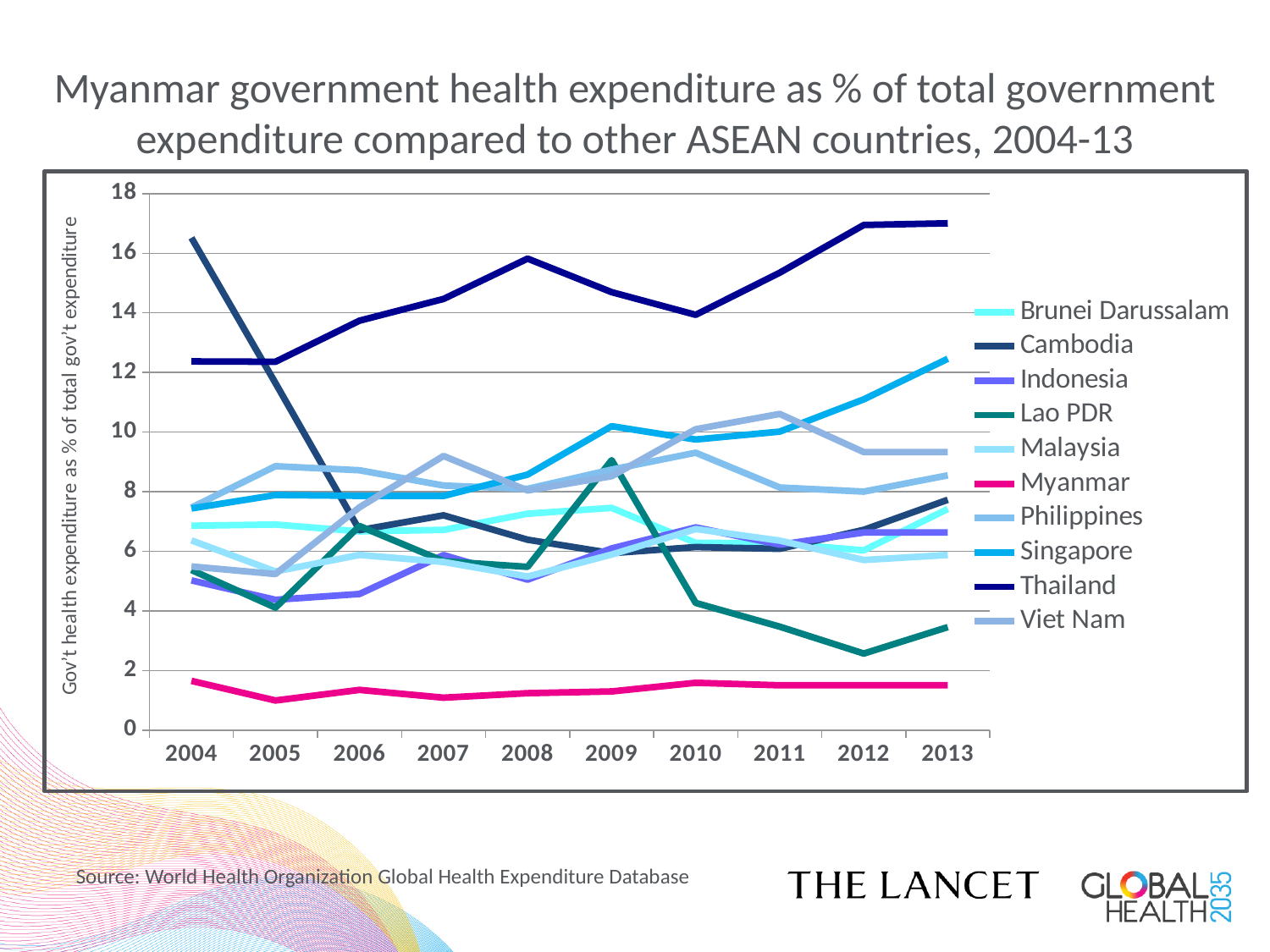
Which country has the highest value in 2004? Cambodia Which country has the lowest value in 2013? Myanmar Which country has the highest value in 2013? Thailand Is the value for Myanmar in 2004 greater or less than 2? less Does the value for Cambodia rise or fall from 2004 to 2006? Fall What kind of chart is shown on the slide? Line chart Is the value for Thailand in 2013 greater or less than 16? greater In 2013, which is larger: the value for Singapore or the value for Lao PDR? Singapore What is the title of the chart? Myanmar government health expenditure as % of total government expenditure compared to other ASEAN countries, 2004-13 Is the value for Lao PDR in 2012 greater or less than 4? less How many years are shown along the x axis? 10 How many countries does the legend list? 10